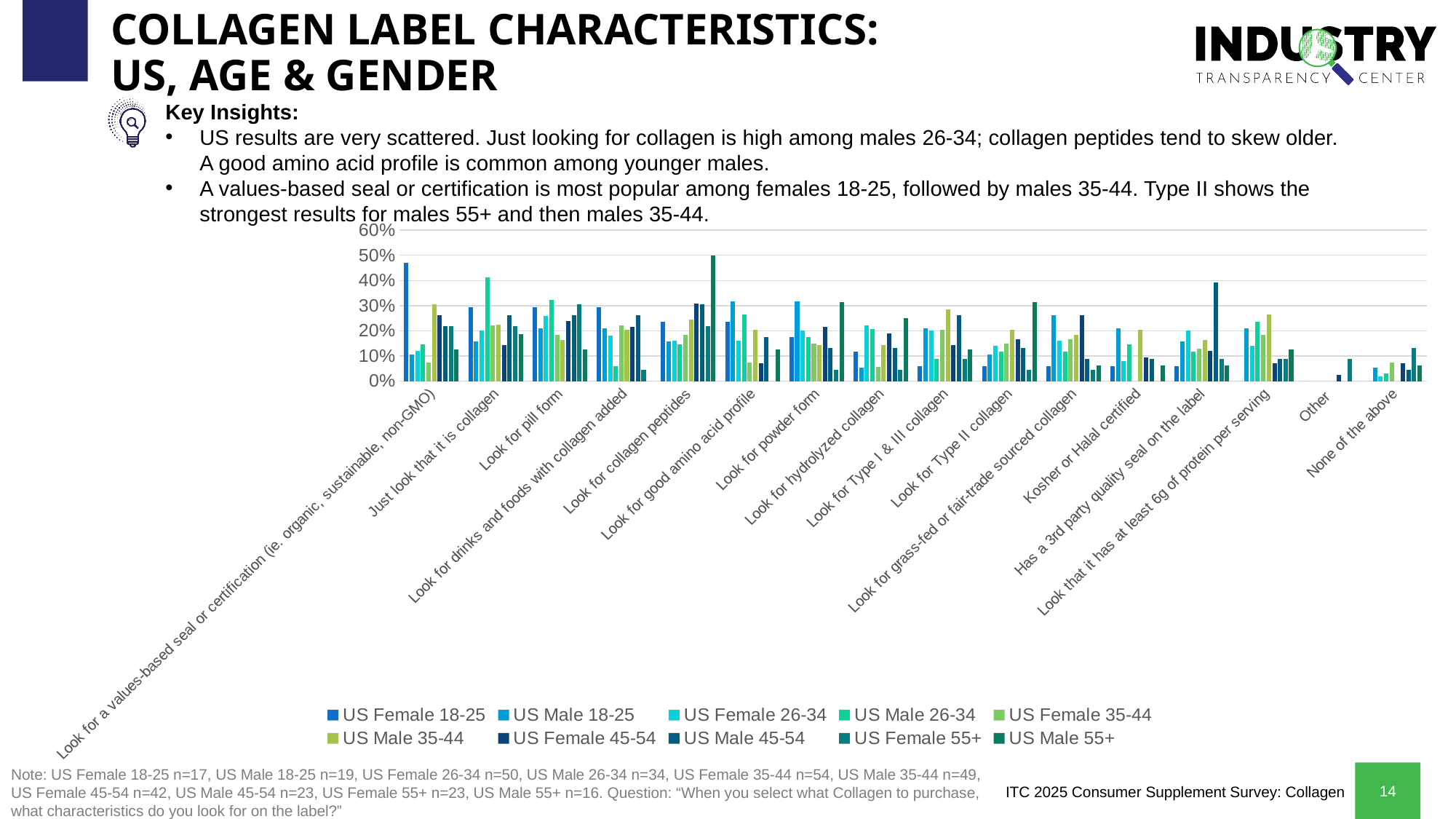
Is the value for US Male 26-34 for "Just look that it is collagen" greater or less than 30%? greater What kind of chart is shown on the slide? bar chart How many label-characteristic categories are shown along the x axis of the chart? 16 What is the highest value shown on the chart's y axis? 60% Is the value for US Female 18-25 for "Look for a values-based seal or certification (ie. organic, sustainable, non-GMO)" greater or less than 40%? greater Is the value for US Male 45-54 for "Look that it has at least 6g of protein per serving" greater or less than 30%? less For the US Male 55+ series, which category has the highest bar? Look for collagen peptides Which series is listed first in the chart legend? US Female 18-25 How many series does the chart legend list? 10 For the US Female 18-25 series, which category has the highest bar? Look for a values-based seal or certification (ie. organic, sustainable, non-GMO)